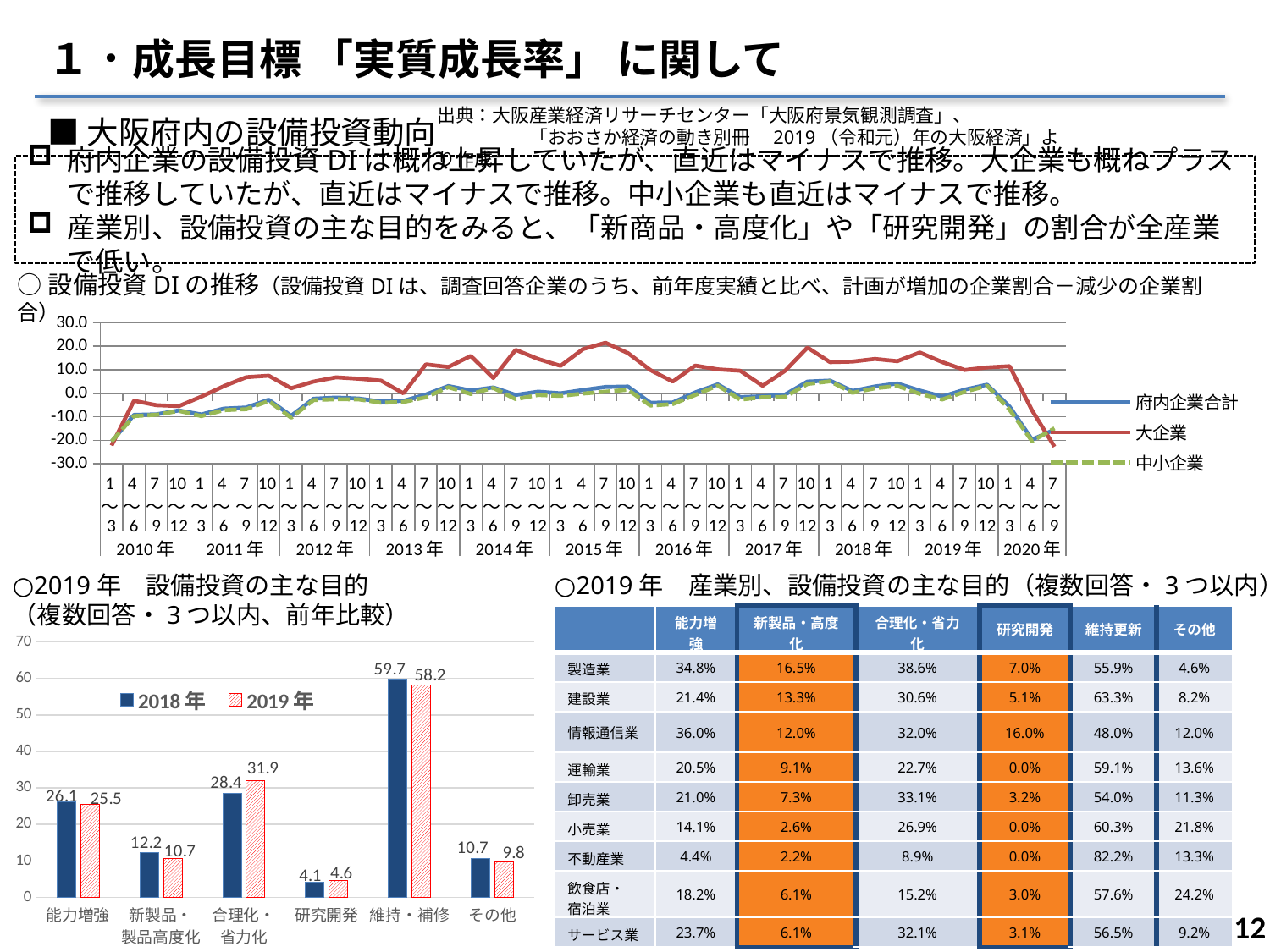
In the bar chart titled 2019年 設備投資の主な目的, what is the difference between the 2018年 and 2019年 values for 能力増強? 0.6 In the bar chart titled 2019年 設備投資の主な目的, which category has the highest 2019年 value? 維持・補修 What kind of chart is the chart titled 設備投資DIの推移? line chart In the bar chart titled 2019年 設備投資の主な目的, how many series does the legend list? 2 In the bar chart titled 2019年 設備投資の主な目的, what is the 2018年 value for 維持・補修? 59.7 In the bar chart titled 2019年 設備投資の主な目的, what is the 2019年 value for 研究開発? 4.6 In the bar chart titled 2019年 設備投資の主な目的, which category has the lowest 2018年 value? 研究開発 In the bar chart titled 2019年 設備投資の主な目的, which is larger for 新製品・製品高度化: the 2018年 value or the 2019年 value? 2018年 In the line chart titled 設備投資DIの推移, is the value for 大企業 at 2020年 7~9 greater or less than -10.0? less In the line chart titled 設備投資DIの推移, how many series does the legend list? 3 In the bar chart titled 2019年 設備投資の主な目的, how many categories are shown on the x axis? 6 In the bar chart titled 2019年 設備投資の主な目的, what is the 2019年 value for 合理化・省力化? 31.9